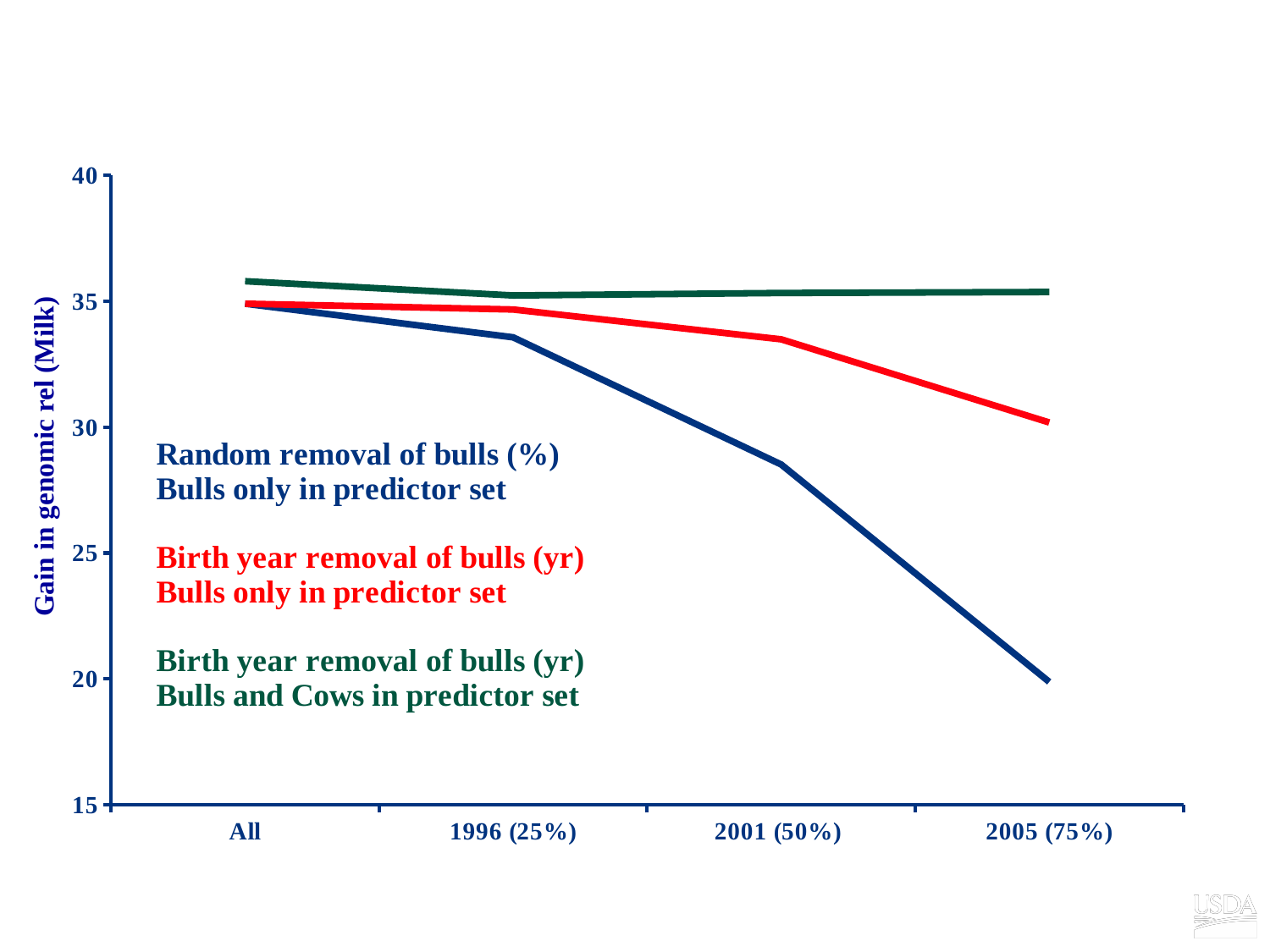
Does the 'Birth year removal of bulls (yr) Bulls only in predictor set' line rise or fall from All to 2005 (75%)? fall At 2001 (50%), which is larger: the 'Birth year removal of bulls (yr) Bulls only in predictor set' value or the 'Random removal of bulls (%) Bulls only in predictor set' value? Birth year removal of bulls (yr) Bulls only in predictor set What kind of chart is shown on the slide? line chart Which series has the lowest value at 2005 (75%)? Random removal of bulls (%) Bulls only in predictor set Is the value for 'Random removal of bulls (%) Bulls only in predictor set' at 2005 (75%) greater or less than 25? less Is the value for 'Birth year removal of bulls (yr) Bulls only in predictor set' at 2005 (75%) greater or less than 35? less How many series are plotted on the chart? 3 How many categories are shown on the x axis? 4 Which series has the highest value at 2005 (75%)? Birth year removal of bulls (yr) Bulls and Cows in predictor set What is the title of the y axis? Gain in genomic rel (Milk) Is the value for 'Random removal of bulls (%) Bulls only in predictor set' at 2001 (50%) greater or less than 25? greater Does the 'Random removal of bulls (%) Bulls only in predictor set' line rise or fall from All to 2005 (75%)? fall